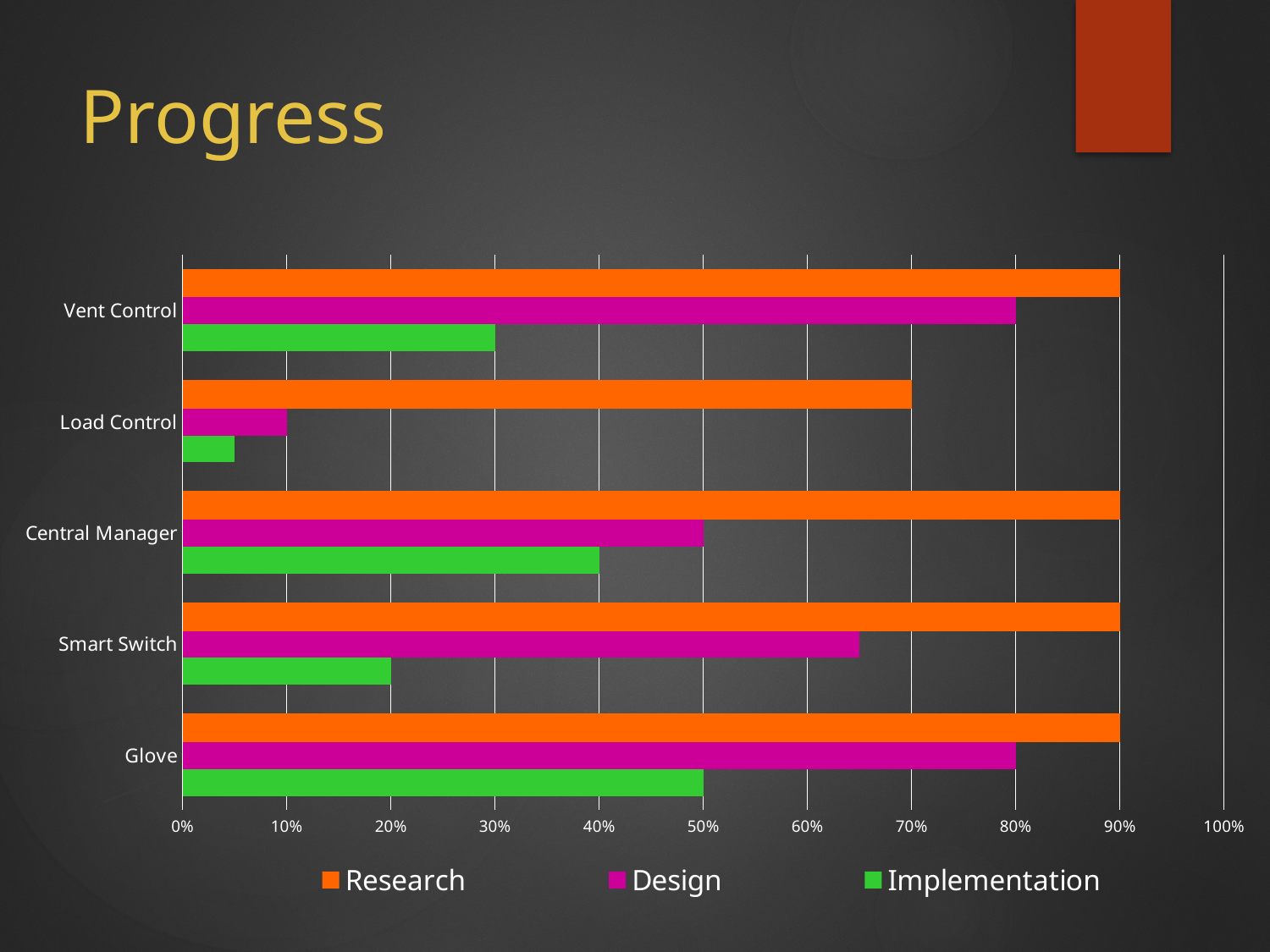
Which category has the lowest Research value? Load Control Which category has the highest Implementation value? Glove How many categories are shown on the chart? 5 What is the Implementation value for Glove? 50% How many series does the legend list? 3 What is the Implementation value for Vent Control? 30% What is the difference between the Research and Implementation values for Vent Control? 60% What is the Design value for Central Manager? 50% Is the Design value for Smart Switch greater or less than 60%? greater Which is larger for Central Manager, the Design value or the Implementation value? Design What is the Research value for Load Control? 70% Is the Implementation value for Load Control greater or less than 10%? less